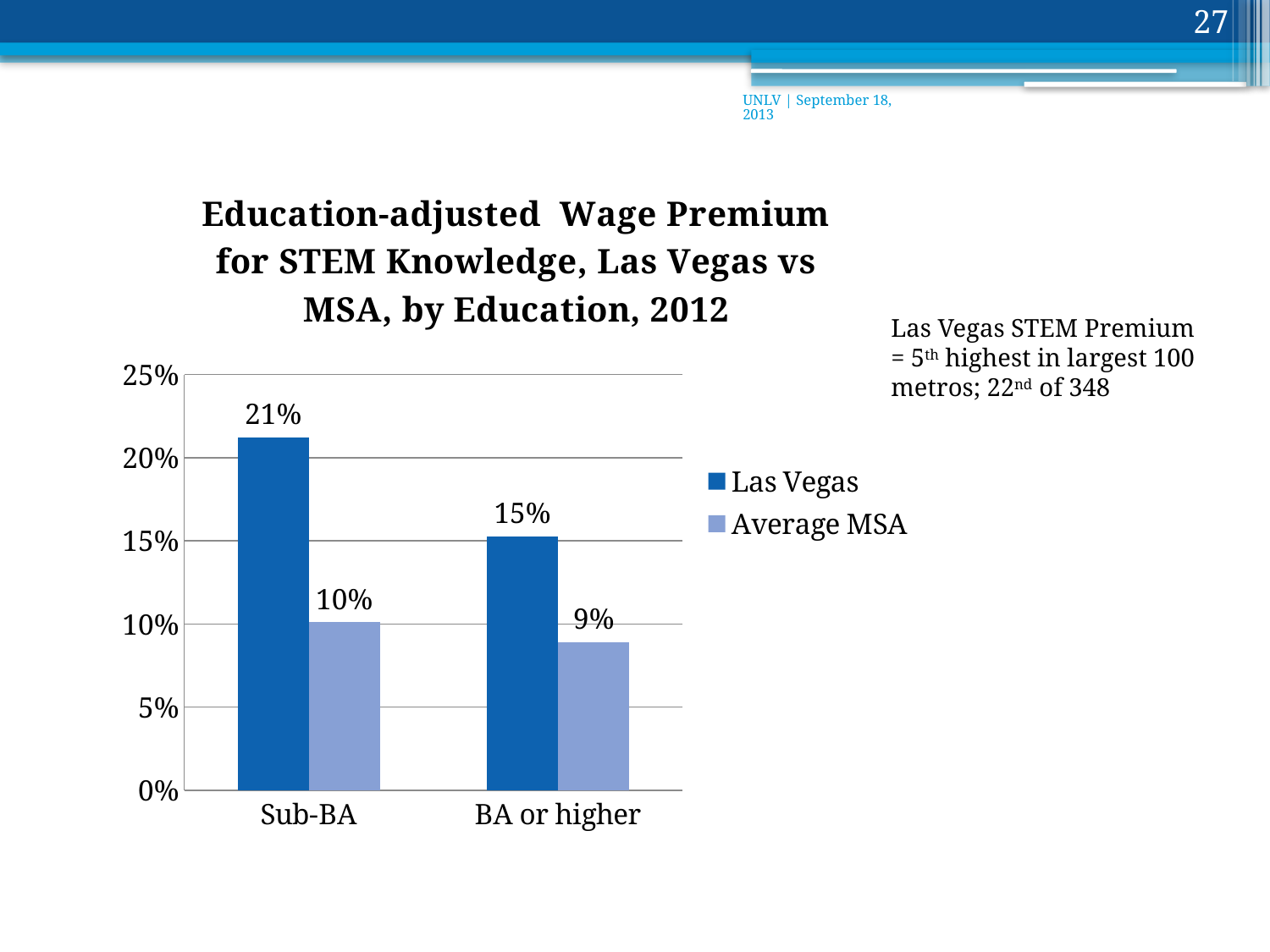
Which bar in the chart has the highest value? Las Vegas, Sub-BA Which series is shown in the darker blue colour? Las Vegas What is the Average MSA value for BA or higher? 9% How many education categories are shown on the x axis? 2 What is the difference between the Las Vegas and Average MSA values for Sub-BA? 11% What is the Las Vegas value for Sub-BA? 21% What is the Las Vegas value for BA or higher? 15% What kind of chart is shown on the slide? Bar chart How many series does the legend list? 2 Which is larger for BA or higher: Las Vegas or Average MSA? Las Vegas What is the Average MSA value for Sub-BA? 10% Which bar in the chart has the lowest value? Average MSA, BA or higher